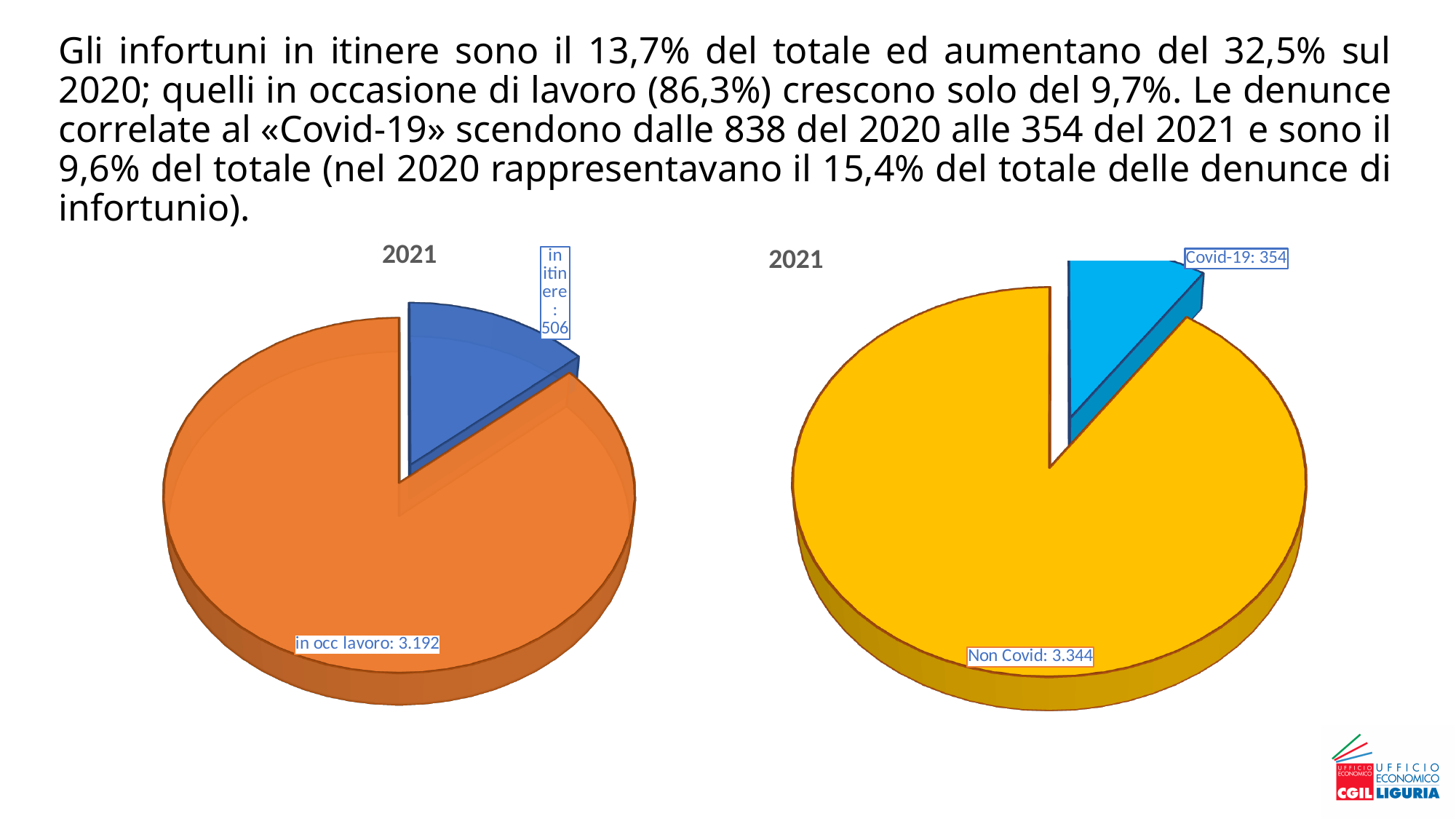
In the right pie chart, which is larger, Covid-19 or Non Covid? Non Covid In the left pie chart, what is the difference between 'in occ lavoro' and 'in itinere'? 2.686 In the left pie chart, what is the value for 'in occ lavoro'? 3.192 In the right pie chart, what is the value for 'Covid-19'? 354 In the right pie chart, what is the total of the two slices? 3.698 In the left pie chart, which slice is the largest? in occ lavoro What kind of chart is the chart on the right? Pie chart In the left pie chart, what is the value for 'in itinere'? 506 In the right pie chart, what is the value for 'Non Covid'? 3.344 In the left pie chart, what share of the total does 'in itinere' represent? 13,7% In the right pie chart, which slice is the smallest? Covid-19 How many slices does the left pie chart have? 2